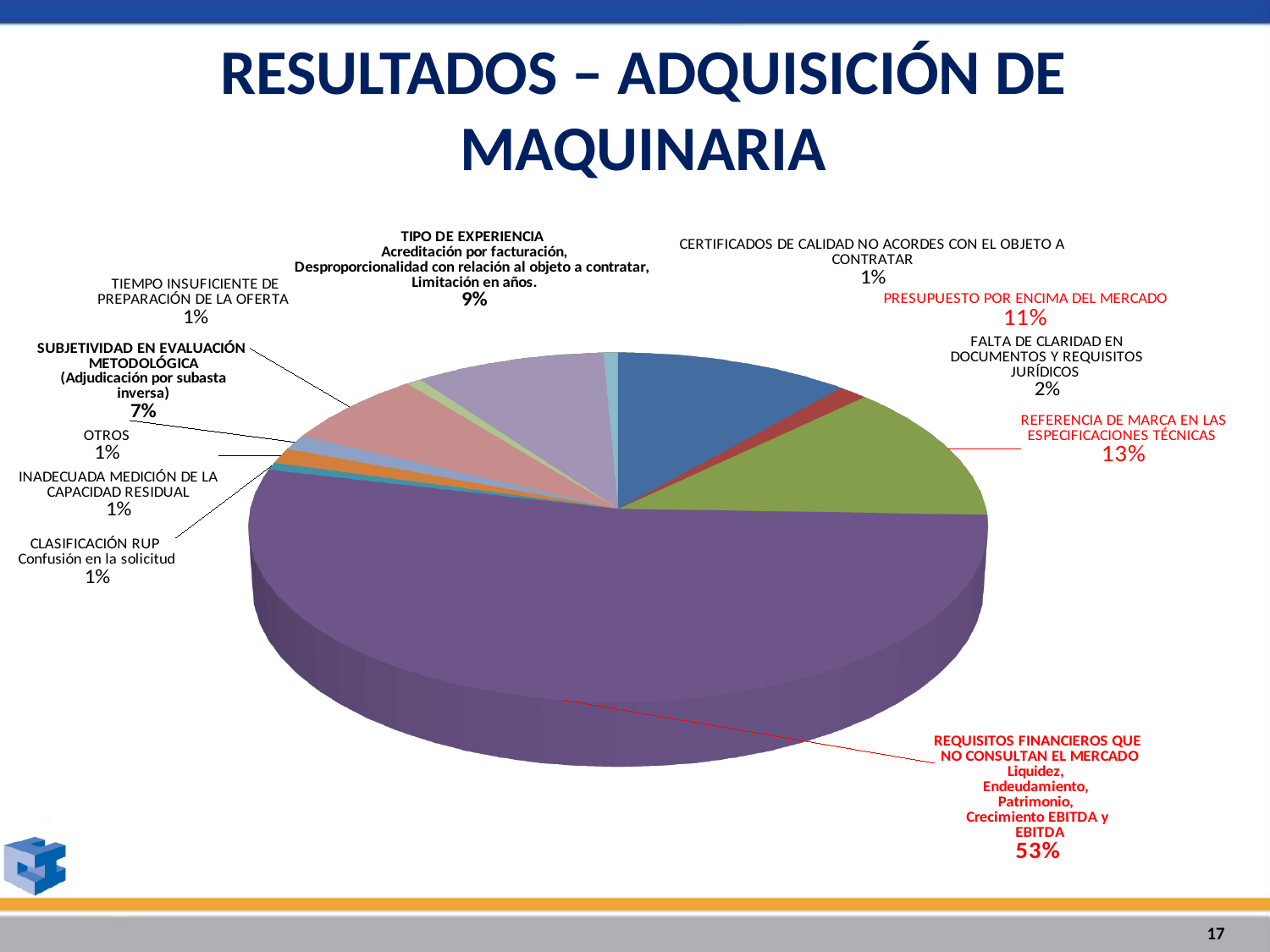
What share of the pie does REQUISITOS FINANCIEROS QUE NO CONSULTAN EL MERCADO represent? 53% What percentage is shown for FALTA DE CLARIDAD EN DOCUMENTOS Y REQUISITOS JURÍDICOS? 2% What is the difference in percentage points between REFERENCIA DE MARCA EN LAS ESPECIFICACIONES TÉCNICAS and PRESUPUESTO POR ENCIMA DEL MERCADO? 2 What percentage is shown for SUBJETIVIDAD EN EVALUACIÓN METODOLÓGICA? 7% What percentage is shown for TIPO DE EXPERIENCIA? 9% What percentage is shown for PRESUPUESTO POR ENCIMA DEL MERCADO? 11% What percentage is shown for REFERENCIA DE MARCA EN LAS ESPECIFICACIONES TÉCNICAS? 13% Which category has the largest share of the pie? REQUISITOS FINANCIEROS QUE NO CONSULTAN EL MERCADO What type of chart is shown on the slide? pie chart How many categories are shown in the pie chart? 11 Which has a larger share: TIPO DE EXPERIENCIA or SUBJETIVIDAD EN EVALUACIÓN METODOLÓGICA? TIPO DE EXPERIENCIA What is the title of the slide? RESULTADOS – ADQUISICIÓN DE MAQUINARIA